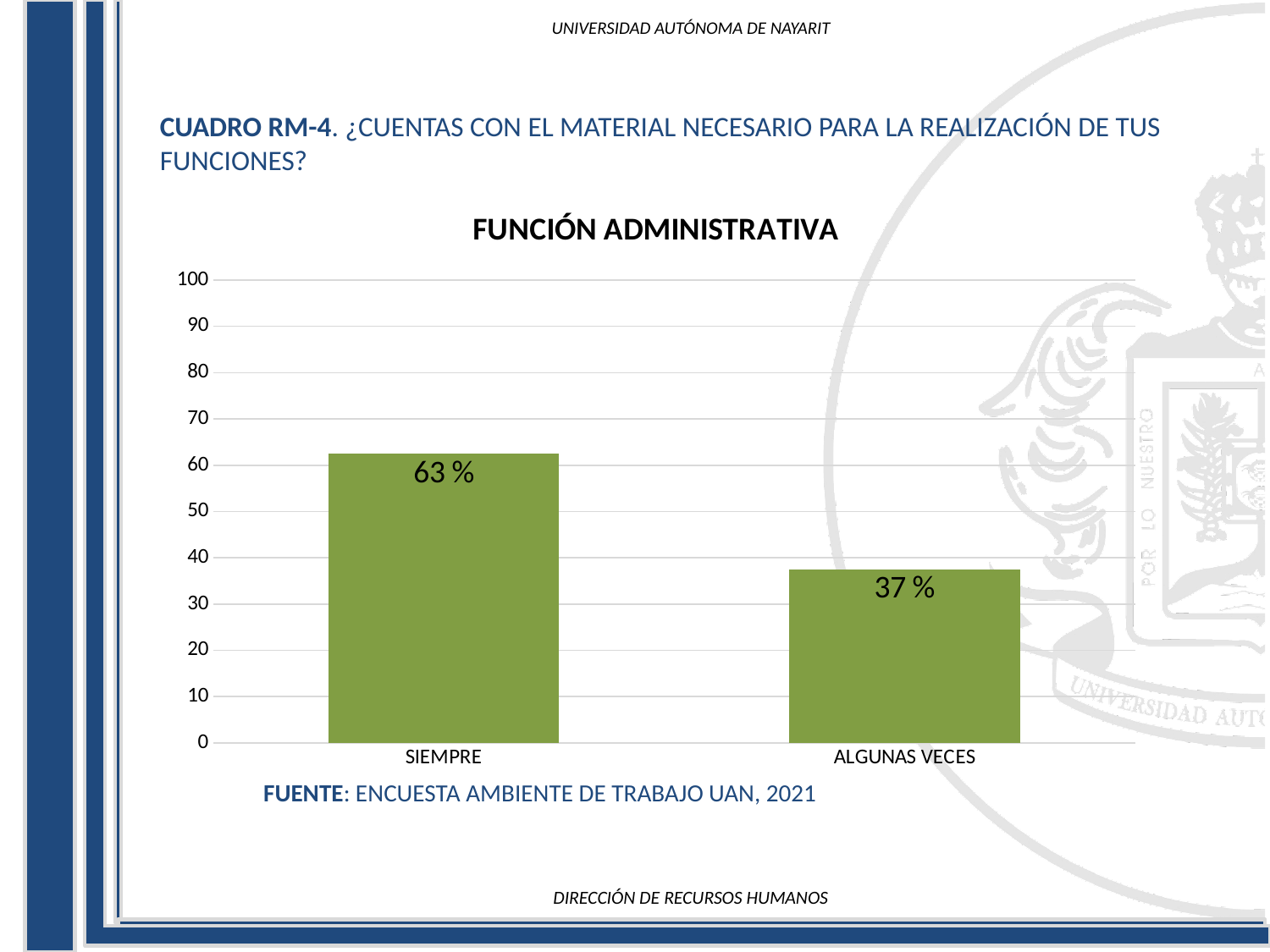
What is the value for SIEMPRE? 63 % Which is larger, the value for SIEMPRE or the value for ALGUNAS VECES? SIEMPRE How many categories are shown on the x axis? 2 Which category has the highest value? SIEMPRE Is the value for SIEMPRE greater or less than 60? greater Is the value for ALGUNAS VECES greater or less than 40? less What kind of chart is shown on the slide? bar chart What is the maximum value shown on the y axis? 100 Which category has the lowest value? ALGUNAS VECES What is the value for ALGUNAS VECES? 37 % What is the title of the chart? FUNCIÓN ADMINISTRATIVA What is the difference between the values for SIEMPRE and ALGUNAS VECES? 26 %